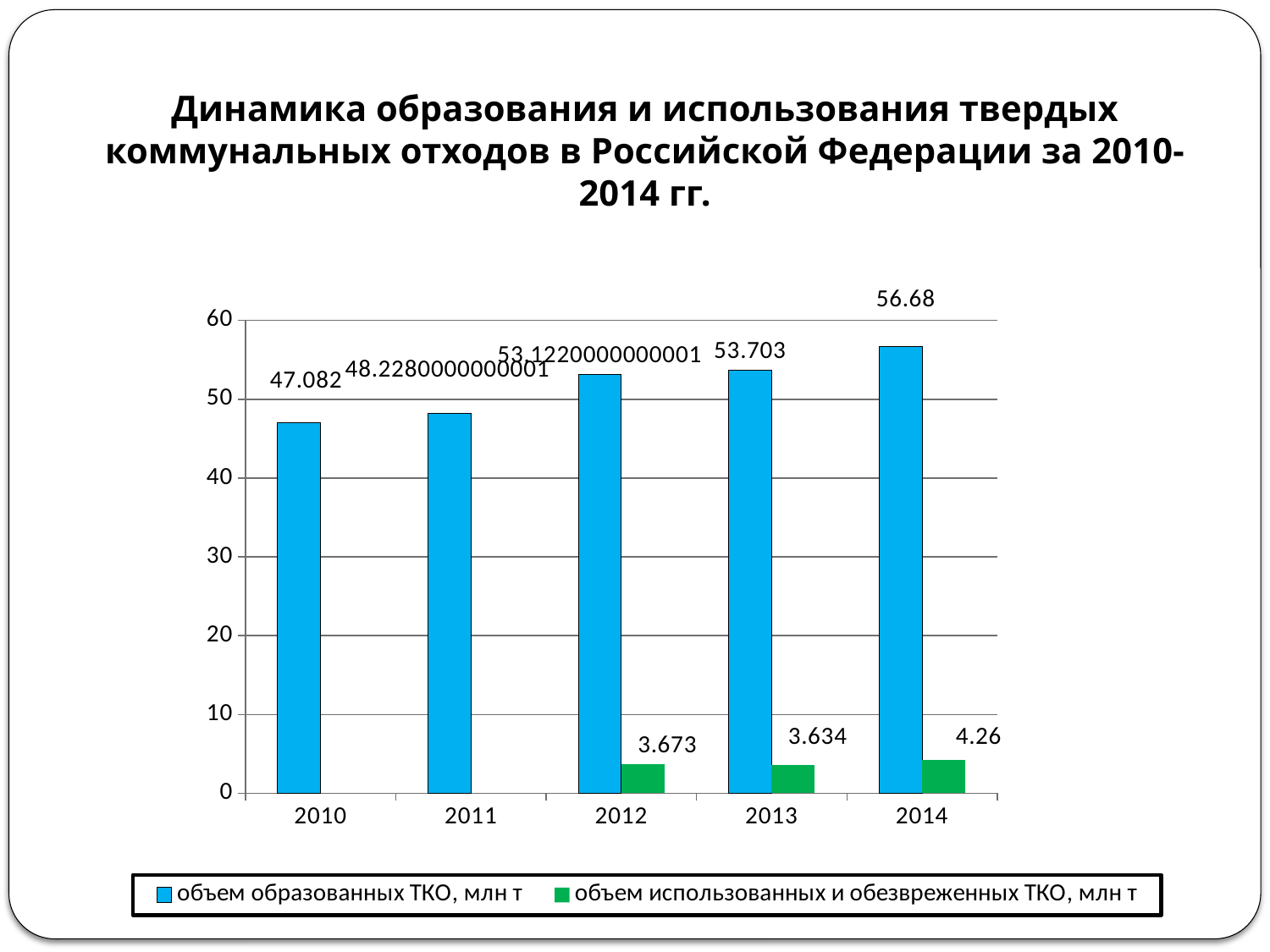
What is the value for объем образованных ТКО, млн т in 2014? 56.68 How many years are shown on the x axis? 5 How many series does the legend list? 2 What is the value for объем образованных ТКО, млн т in 2010? 47.082 Does объем образованных ТКО, млн т rise or fall from 2010 to 2014? rise What is the value for объем использованных и обезвреженных ТКО, млн т in 2012? 3.673 Which is larger: объем использованных и обезвреженных ТКО, млн т in 2014 or in 2013? 2014 What is the value for объем использованных и обезвреженных ТКО, млн т in 2014? 4.26 Is the value for объем образованных ТКО, млн т in 2011 greater or less than 50? less In which year is объем образованных ТКО, млн т the highest? 2014 In which year is объем образованных ТКО, млн т the lowest? 2010 What is the difference between объем образованных ТКО, млн т in 2014 and in 2010? 9.598